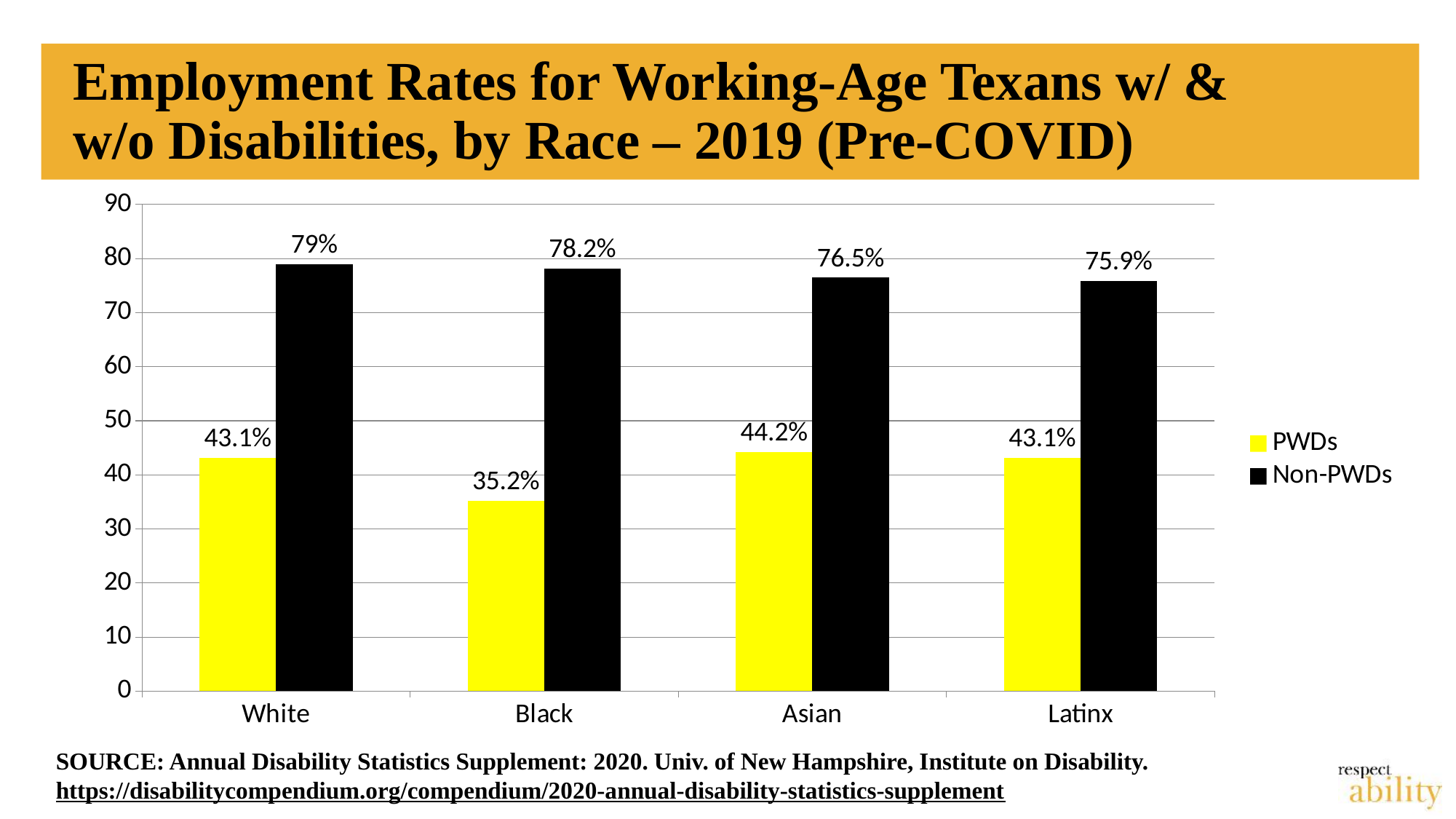
Which is larger, the PWDs employment rate for Asian or for Black? Asian What is the difference between the Non-PWDs and PWDs employment rates in the Black category? 43 percentage points Which race category has the lowest employment rate for PWDs? Black What is the employment rate for PWDs in the Asian category? 44.2% How many race categories are shown on the x axis? 4 Which race category has the highest employment rate for Non-PWDs? White How many series does the legend list? 2 What colour are the bars for the PWDs series? Yellow What is the employment rate for PWDs in the White category? 43.1% What is the employment rate for Non-PWDs in the Black category? 78.2% What kind of chart is shown on the slide? Bar chart What is the employment rate for Non-PWDs in the Latinx category? 75.9%